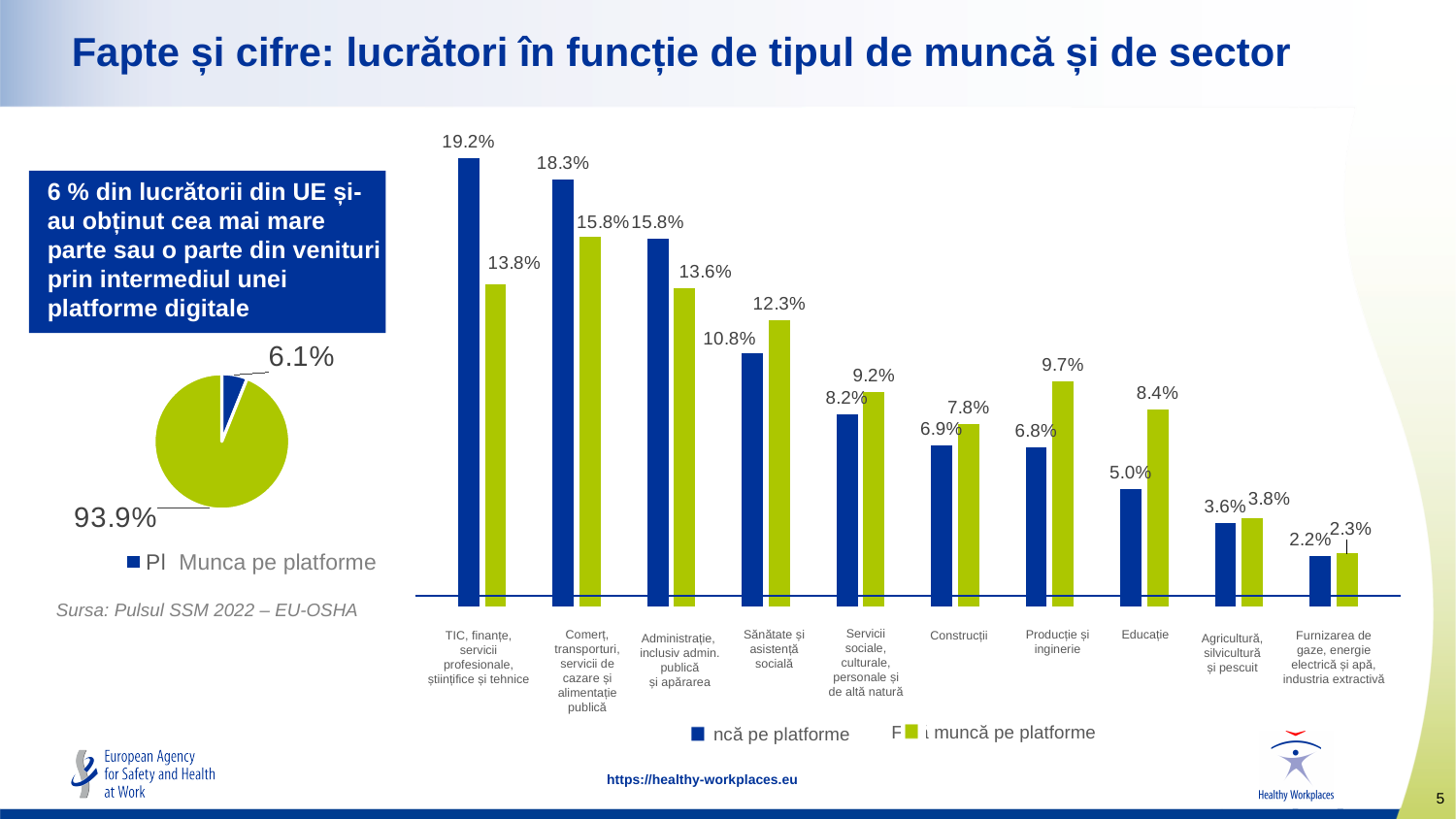
On the bar chart on the right, which category has the highest blue bar? TIC, finanțe, servicii profesionale, științifice și tehnice On the bar chart on the right, what is the difference between the blue and green bars for Producție și inginerie? 2.9% On the pie chart on the left, what is the value of the larger (green) slice? 93.9% On the bar chart on the right, what is the difference between the blue bars for TIC, finanțe, servicii profesionale, științifice și tehnice and Comerț, transporturi, servicii de cazare și alimentație publică? 0.9% On the bar chart on the right, which is larger for Sănătate și asistență socială: the blue bar or the green bar? the green bar On the bar chart on the right, what is the value of the blue bar for Construcții? 6.9% What kind of chart is the chart on the right of the slide? bar chart On the pie chart on the left, what share does the smaller (blue) slice represent? 6.1% How many categories are shown on the bar chart on the right? 10 How many series does the legend of the bar chart on the right list? 2 On the bar chart on the right, which category has the lowest green bar? Furnizarea de gaze, energie electrică și apă, industria extractivă On the bar chart on the right, what is the value of the green bar for Educație? 8.4%